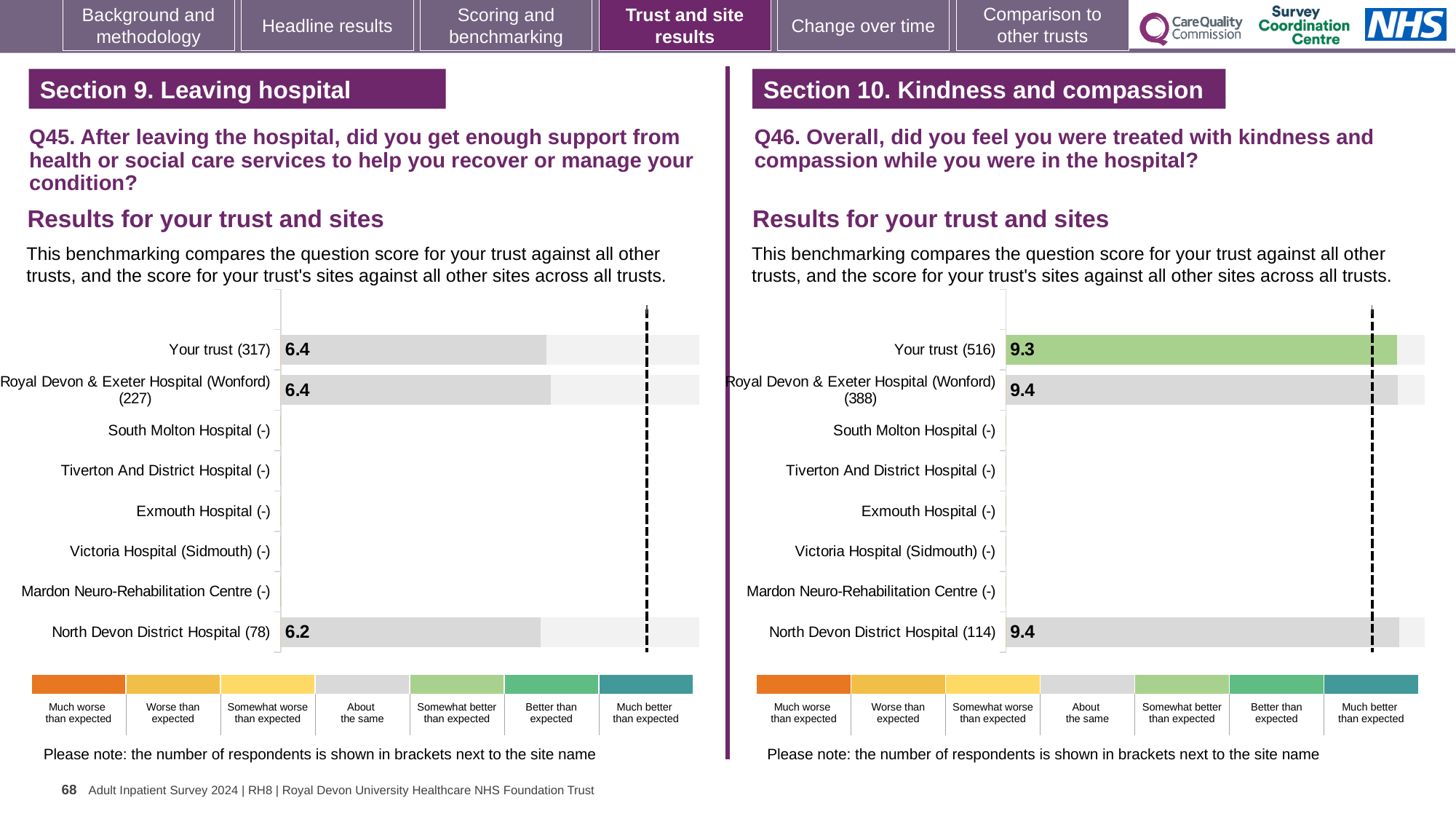
In the Q45 chart on the left, which site with a printed score has the lowest value? North Devon District Hospital In the Q45 chart on the left, what is the score for North Devon District Hospital? 6.2 How many sites (including Your trust) are listed on the y axis of the Q46 chart on the right? 8 In the Q45 chart on the left, what is the difference between the score for Your trust and the score for North Devon District Hospital? 0.2 In the Q46 chart on the right, what colour is the bar for Your trust? Green In the Q45 chart on the left, what is the score for Your trust? 6.4 In the Q46 chart on the right, which is larger: the score for Your trust or the score for Royal Devon & Exeter Hospital (Wonford)? Royal Devon & Exeter Hospital (Wonford) In the Q46 chart on the right, what is the score for Your trust? 9.3 In the Q46 chart on the right, what is the score for North Devon District Hospital? 9.4 In the Q45 chart on the left, what is the score for Royal Devon & Exeter Hospital (Wonford)? 6.4 In the Q46 chart on the right, what is the score for Royal Devon & Exeter Hospital (Wonford)? 9.4 What kind of chart is used for the Q45 results on the left? Bar chart